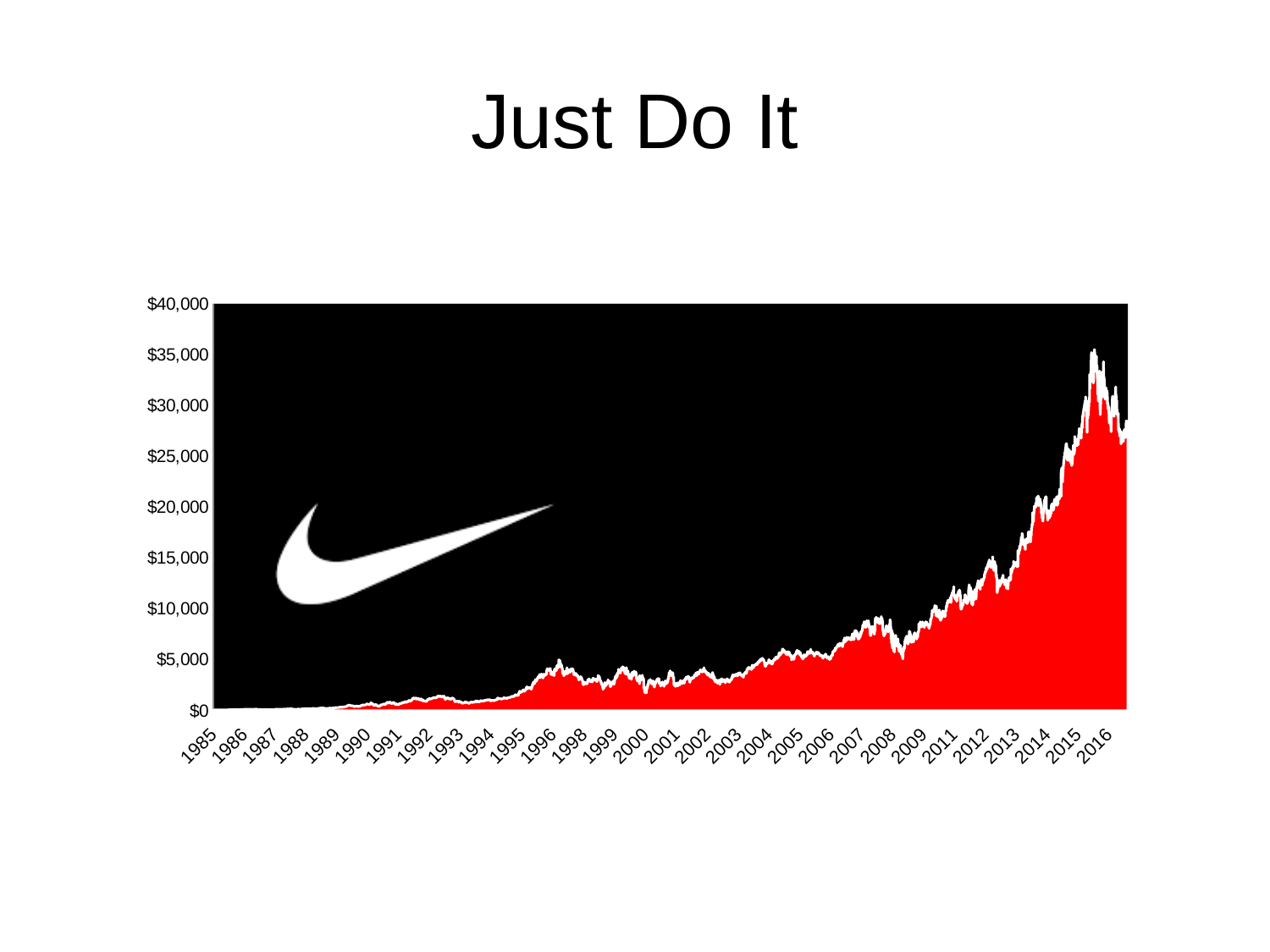
In which year does the chart reach its highest peak? 2015 What is the highest value shown on the y axis? $40,000 What kind of chart is shown on the slide? area chart Is the highest peak of the chart greater or less than $40,000? less Is the value at the end of 2016 greater or less than $25,000? greater Is the highest peak of the chart greater or less than $30,000? greater What is the title of the slide? Just Do It How many year labels are shown on the x axis? 30 Overall, do the values rise or fall from 1985 to 2016? rise